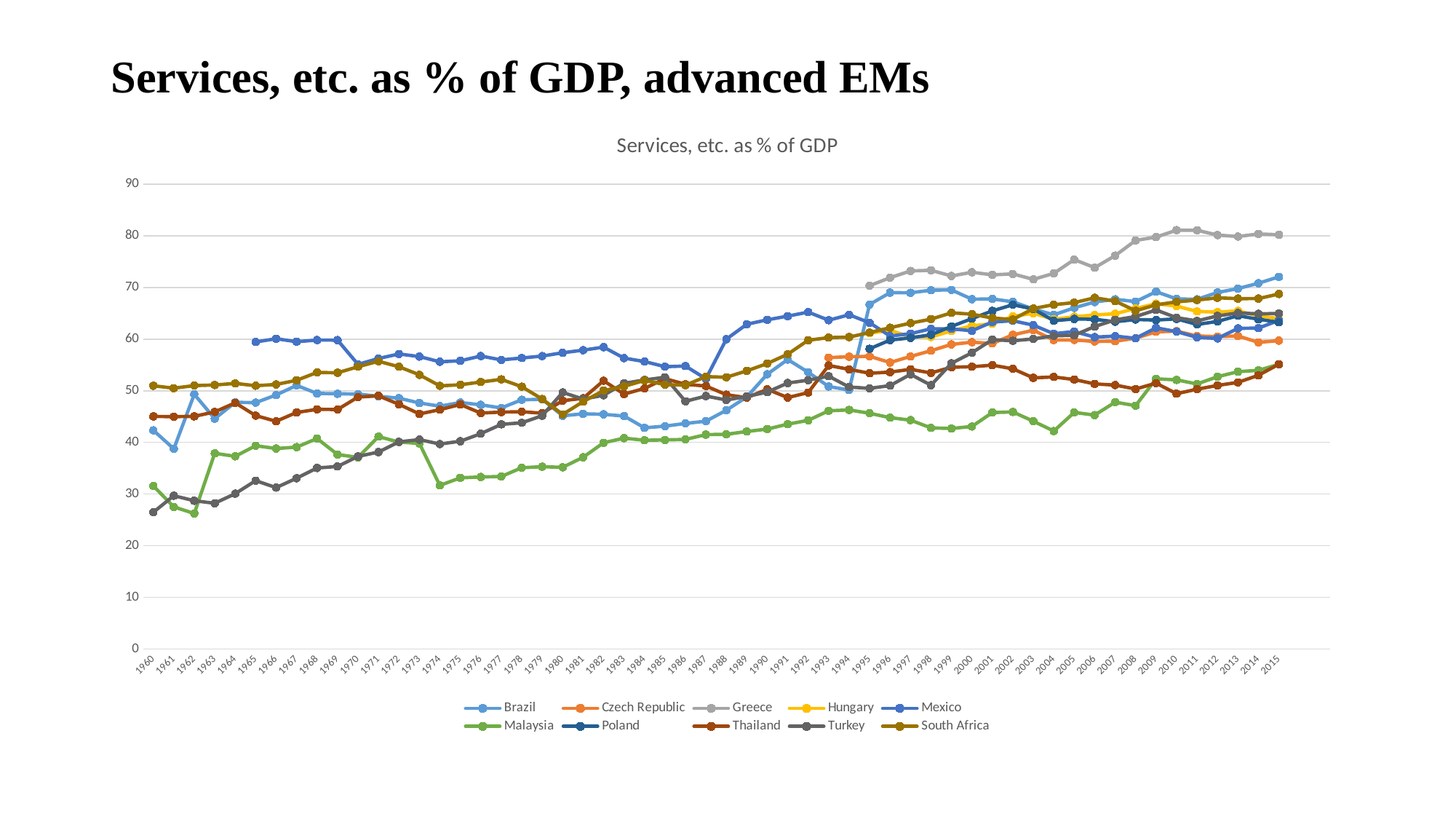
Is the value for Malaysia in 1974 greater or less than 40? less How many series does the legend list? 10 What is the title of the chart? Services, etc. as % of GDP What is the first year shown on the x axis? 1960 Does the value for Turkey generally rise or fall from 1960 to 2015? rise Which country has the highest value in 2015? Greece In 2015, which is larger: the value for Greece or the value for Brazil? Greece Which country has the lowest value in 1960? Turkey What kind of chart is shown on the slide? line chart Is the value for Greece in 2015 greater or less than 70? greater In 2000, which is larger: the value for Greece or the value for Malaysia? Greece Is the value for Turkey in 1960 greater or less than 30? less